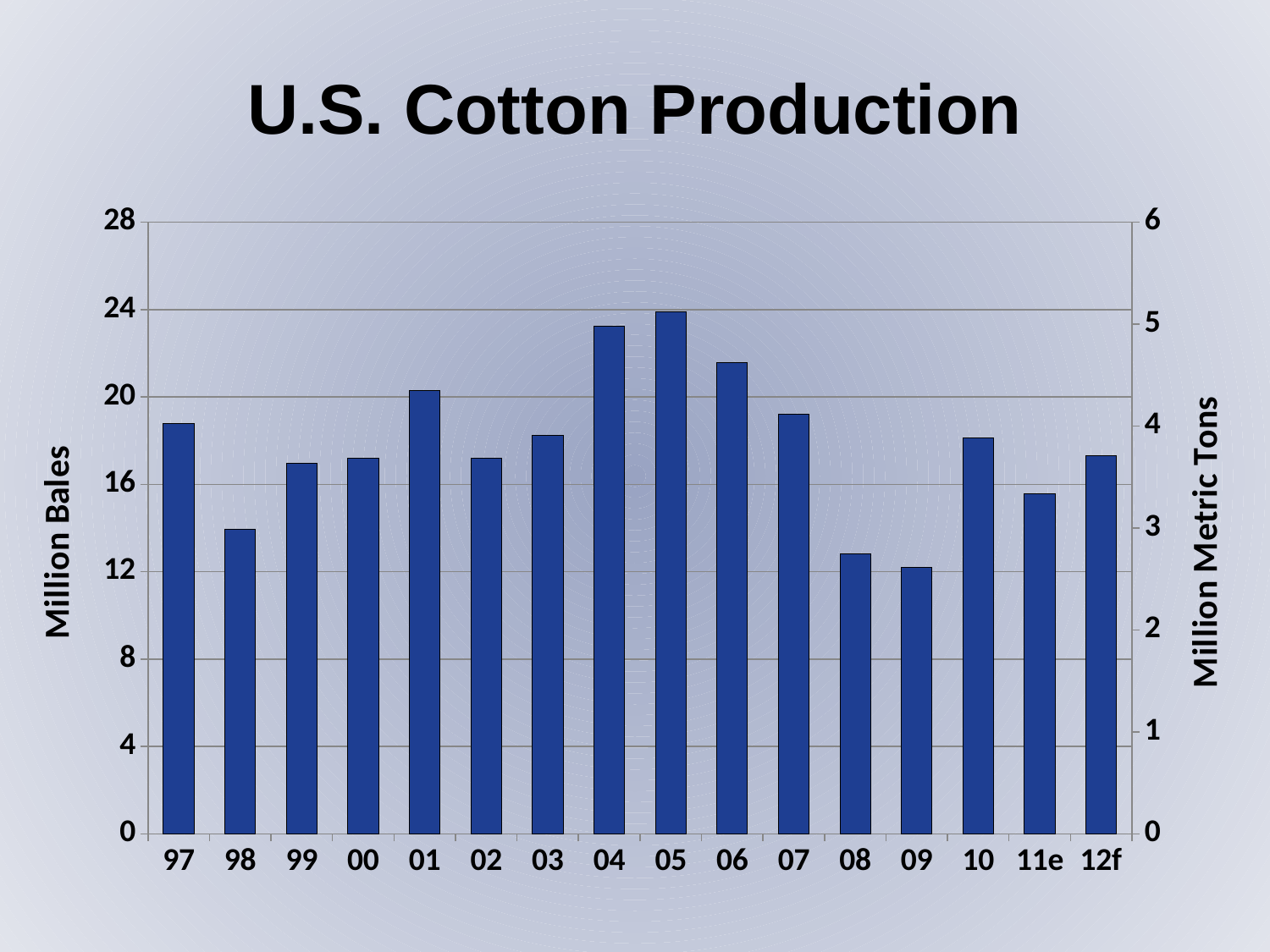
Is the value for 07 greater or less than 20 million bales? less Which year has the lowest cotton production? 09 Is the value for 04 greater or less than 20 million bales? greater Which year has the larger production, 04 or 08? 04 Is the value for 98 greater or less than 16 million bales? less What kind of chart is shown on the slide? bar chart Do the values rise or fall from 05 to 09? fall What is the title of the chart? U.S. Cotton Production Which year has the highest cotton production? 05 What is the label on the left vertical axis? Million Bales How many years (bars) are shown on the x axis? 16